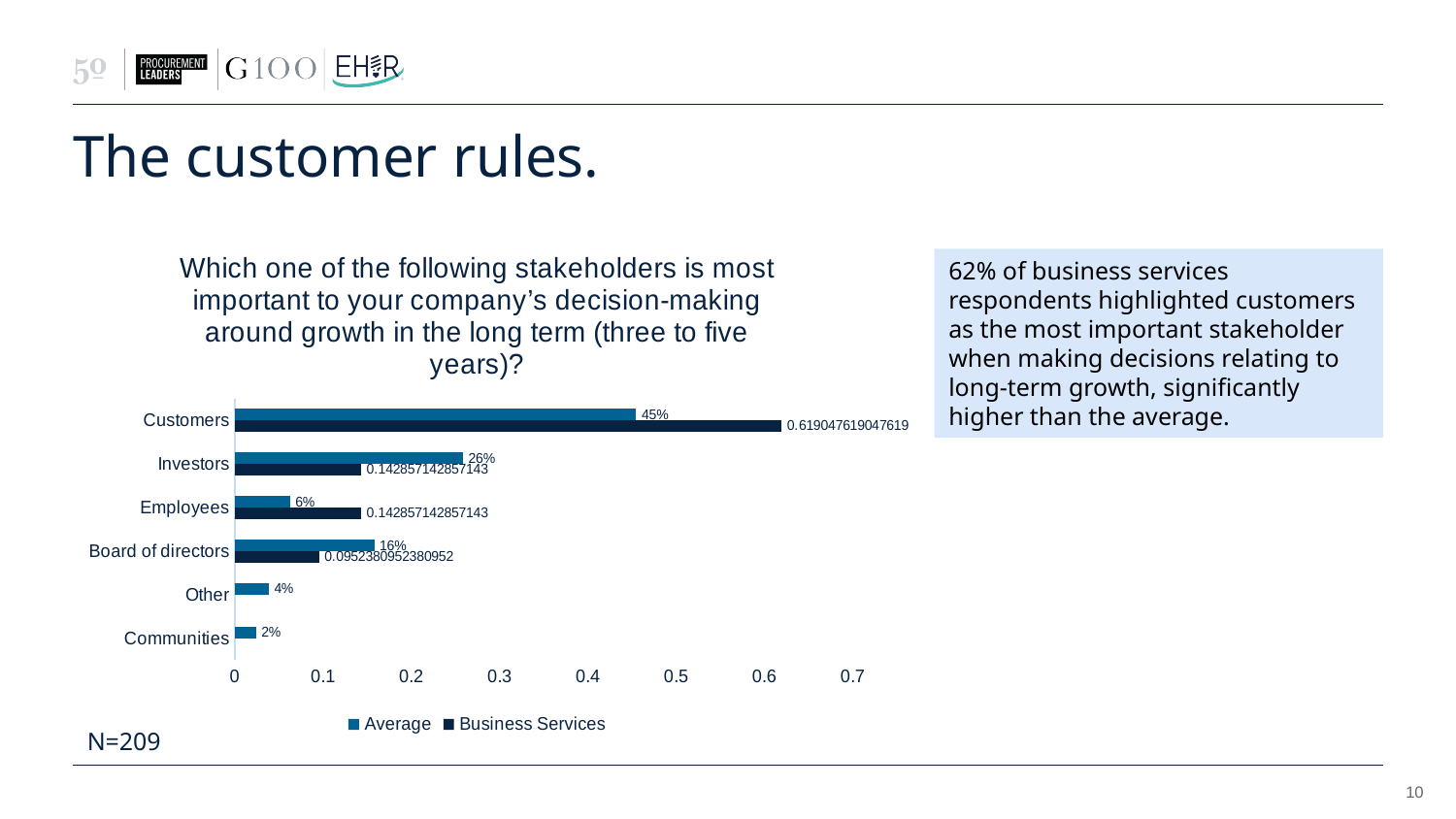
How many series does the legend list? 2 Which stakeholder has the lowest Average value? Communities What kind of chart is shown on the slide? Bar chart What is the difference between the Average values for Investors and Employees? 20% What is the Average value for Investors? 26% What is the Average value for Customers? 45% What is the Business Services value for Board of directors? 0.0952380952380952 Is the Average value for Customers greater or less than 0.4? greater Which stakeholder has the highest Average value? Customers Which is larger for Customers, the Average value or the Business Services value? Business Services How many stakeholder categories are shown on the chart? 6 What is the Business Services value for Customers? 0.619047619047619